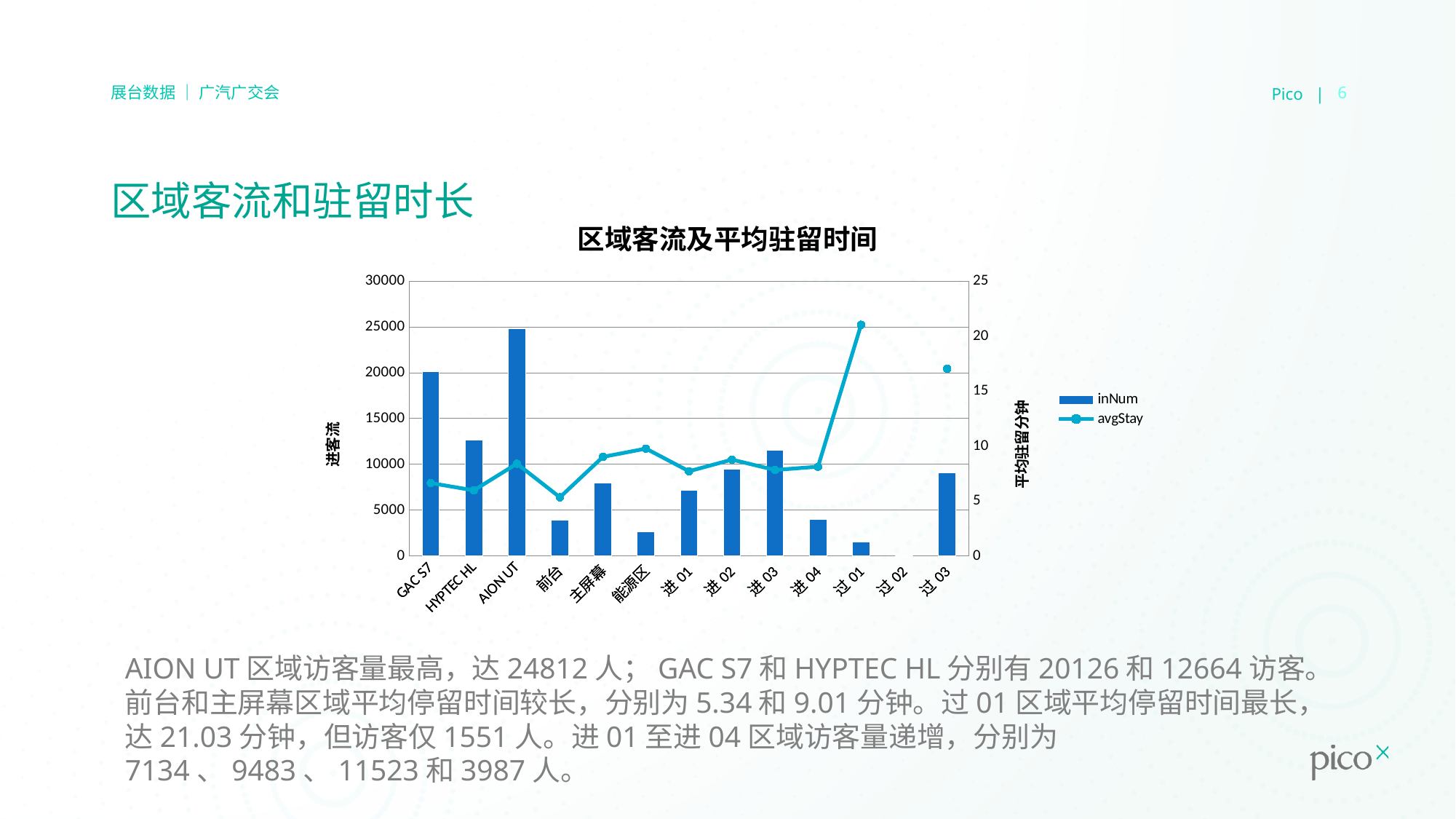
Which category has the highest inNum bar? AION UT What type of chart is shown on the slide? A combined bar and line chart How many categories are shown on the x axis of the chart? 13 Is the inNum value for 能源区 greater or less than 5000? less What is the title of the chart? 区域客流及平均驻留时间 How many series does the chart legend list? 2 What is the avgStay value for 过 01? 21.03 Which has a larger inNum value, GAC S7 or HYPTEC HL? GAC S7 What is the difference in inNum between AION UT and GAC S7? 4686 What is the inNum value for AION UT? 24812 Is the avgStay value for 过 03 greater or less than 15? greater Which category has the highest avgStay value? 过 01